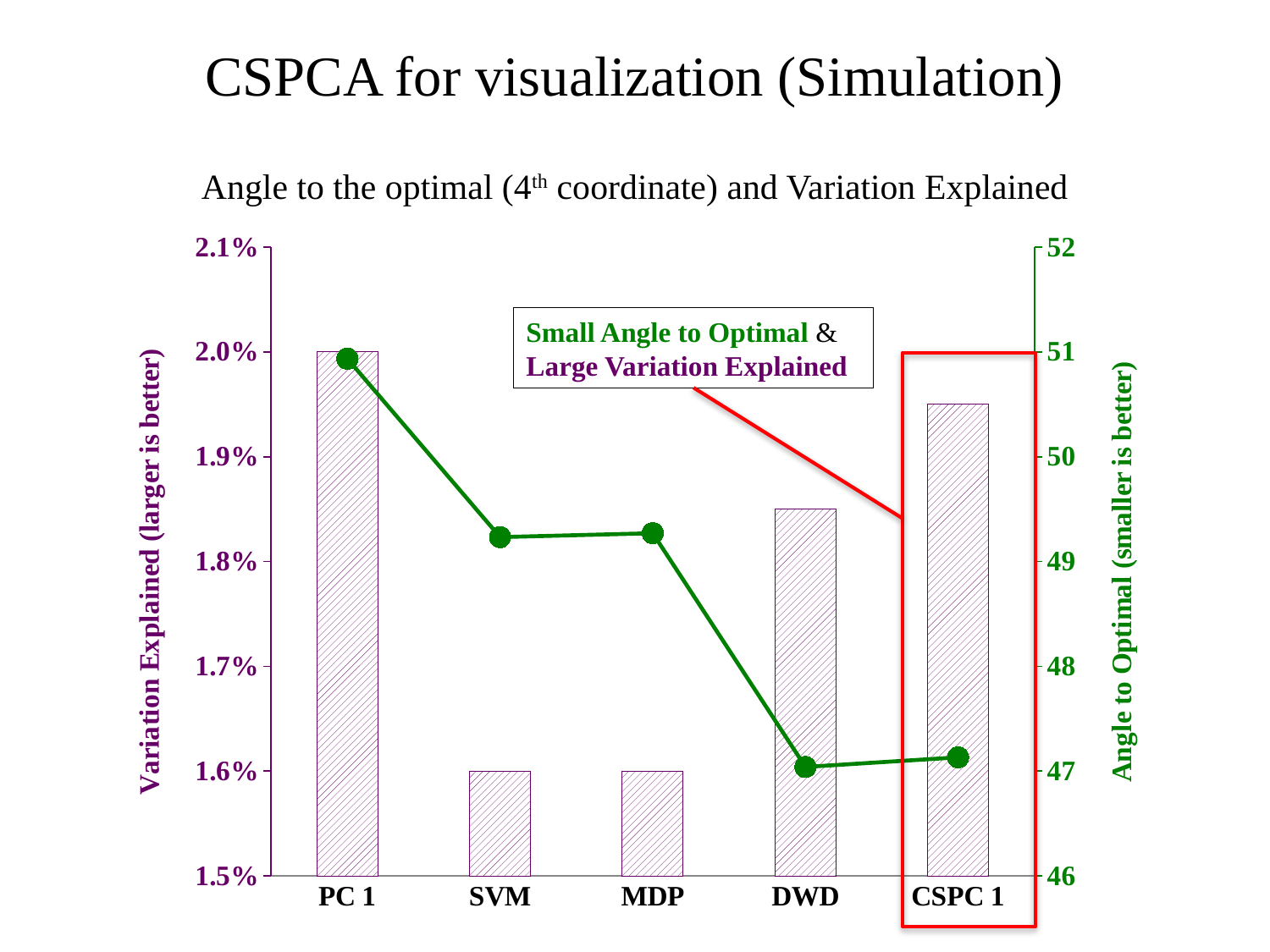
Is the Angle to Optimal for SVM greater or less than 49? greater Is the Variation Explained for DWD greater or less than 1.8%? greater What is the Variation Explained value for SVM? 1.6% What is the Variation Explained value for MDP? 1.6% Which has the larger Variation Explained, DWD or CSPC 1? CSPC 1 How many categories are shown on the x axis? 5 What is the Variation Explained value for PC 1? 2.0% Which category has the highest Variation Explained bar? PC 1 Is the Variation Explained for CSPC 1 greater or less than 1.9%? greater Which category has the highest Angle to Optimal? PC 1 Does the Angle to Optimal line generally rise or fall from PC 1 to CSPC 1? fall